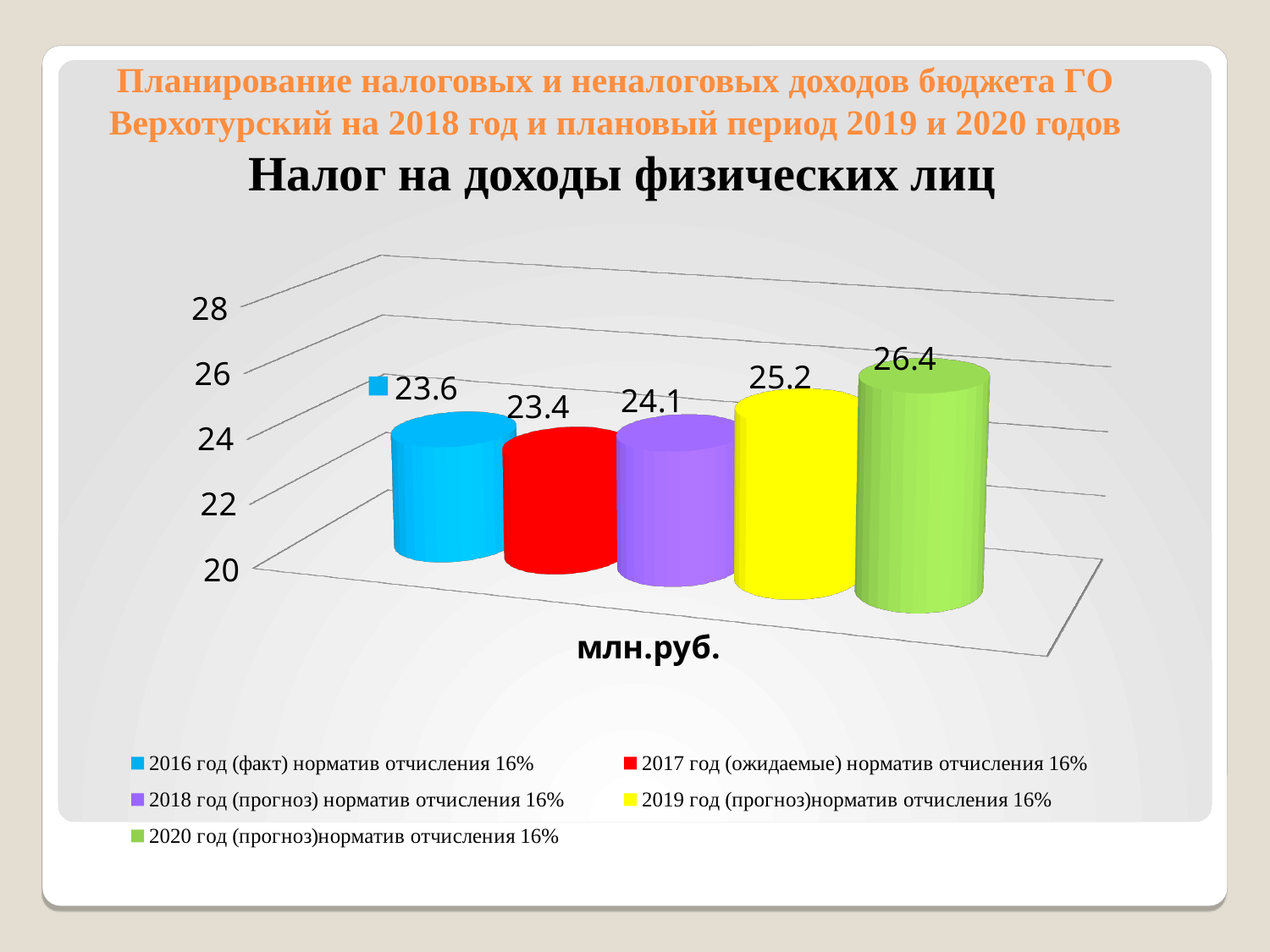
What unit label is shown below the chart? млн.руб. What is the difference between the 2019 value and the 2018 value? 1.1 Which is larger, the value for 2019 or the value for 2018? 2019 Which year has the lowest value in the chart? 2017 год (ожидаемые) Which year has the highest value in the chart? 2020 год (прогноз) What is the value for 2017 год (ожидаемые) in the chart? 23.4 What is the difference between the 2020 value and the 2016 value? 2.8 What is the value for 2020 год (прогноз) in the chart? 26.4 What is the value for 2018 год (прогноз) in the chart? 24.1 What kind of chart is shown on the slide? Bar chart How many series does the legend list? 5 What is the value for 2016 год (факт) in the chart? 23.6